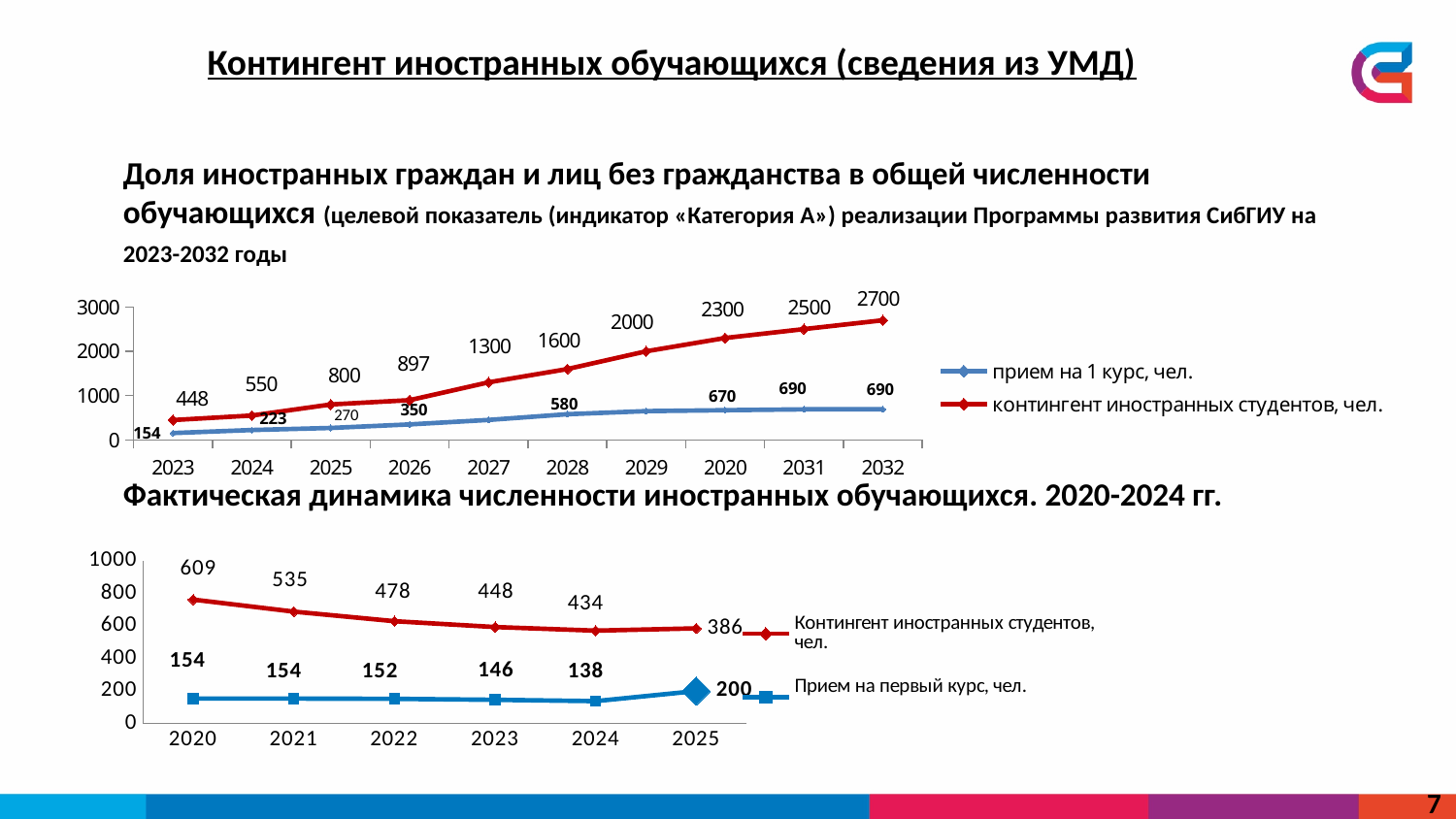
In the top chart (target indicators 2023-2032), what is the value of 'контингент иностранных студентов, чел.' for 2032? 2700 In the top chart (target indicators 2023-2032), does the 'контингент иностранных студентов, чел.' series rise or fall from 2023 to 2032? rises In the top chart (target indicators 2023-2032), what is the value of 'прием на 1 курс, чел.' for 2023? 154 In the bottom chart (Фактическая динамика 2020-2024), what is the value of 'Прием на первый курс, чел.' for 2025? 200 In the bottom chart (Фактическая динамика 2020-2024), what is the difference between the 'Контингент иностранных студентов' values for 2020 and 2025? 223 How many years are plotted on the x axis of the bottom chart (Фактическая динамика 2020-2024)? 6 What kind of chart is the top chart (target indicators 2023-2032)? line chart In the top chart (target indicators 2023-2032), what is the value of 'контингент иностранных студентов, чел.' for 2027? 1300 In the bottom chart (Фактическая динамика 2020-2024), what is the value of 'Контингент иностранных студентов, чел.' for 2020? 609 In the top chart (target indicators 2023-2032), what is the difference between 'контингент иностранных студентов' and 'прием на 1 курс' in 2032? 2010 In the bottom chart (Фактическая динамика 2020-2024), which year has the lowest value for 'Контингент иностранных студентов, чел.'? 2025 How many series does the legend of the top chart (target indicators 2023-2032) list? 2